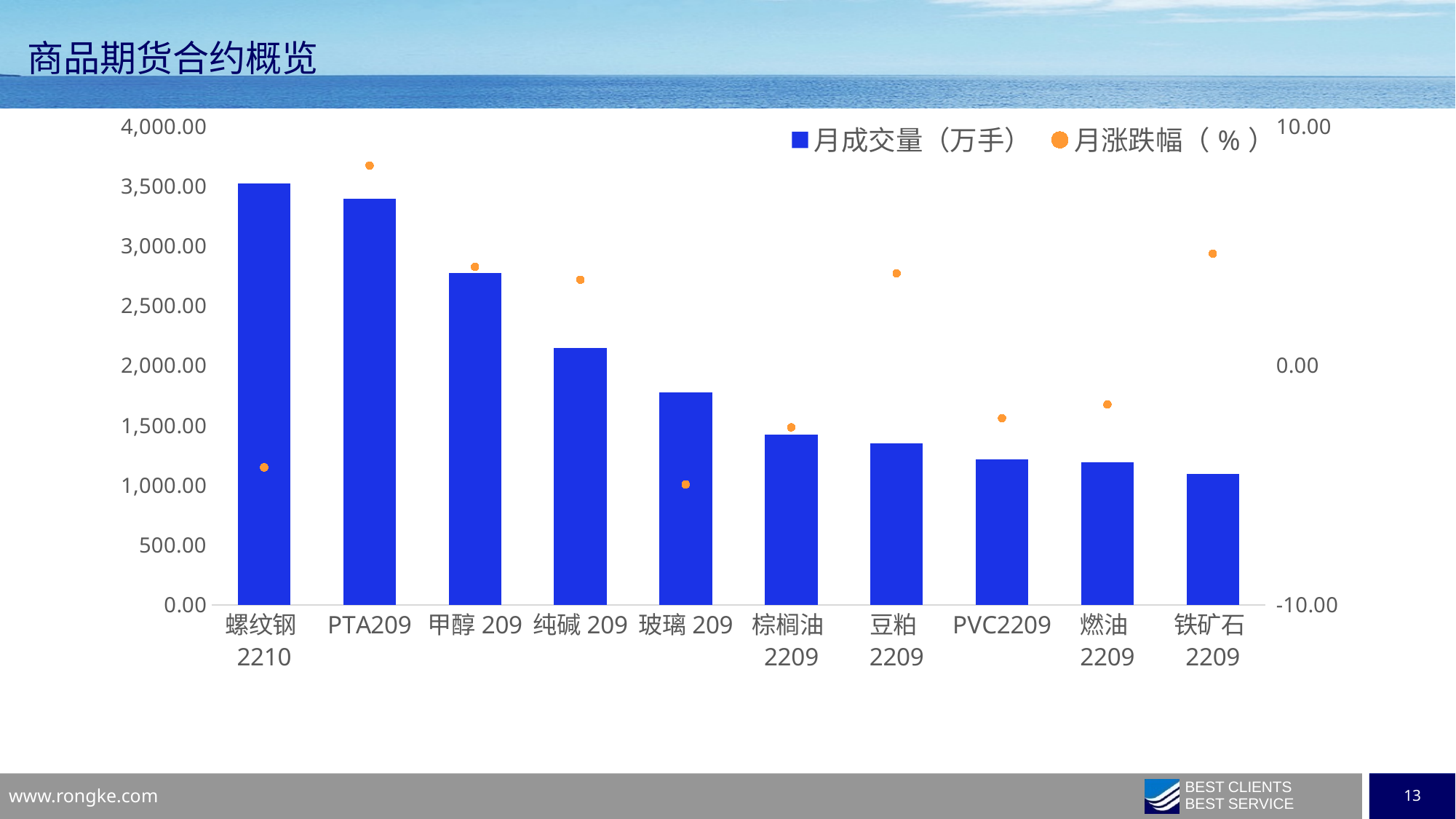
Which contract has the lowest 月成交量（万手）? 铁矿石 2209 Is the 月成交量（万手） for 铁矿石 2209 greater or less than 1,000.00? greater How many series does the legend list? 2 Which contract has the highest 月成交量（万手）? 螺纹钢2210 Is the 月成交量（万手） for 玻璃 209 greater or less than 2,000.00? less Do the 月成交量（万手） bars rise or fall from left to right along the x axis? fall Which contract has the highest 月涨跌幅（%）? PTA209 How many contracts (categories) are shown on the x axis? 10 What kind of chart is shown on the slide? bar chart (with points for the second series on a secondary axis) Is the 月成交量（万手） for PTA209 greater or less than 3,000.00? greater Which has the larger 月成交量（万手）, 甲醇 209 or 纯碱 209? 甲醇 209